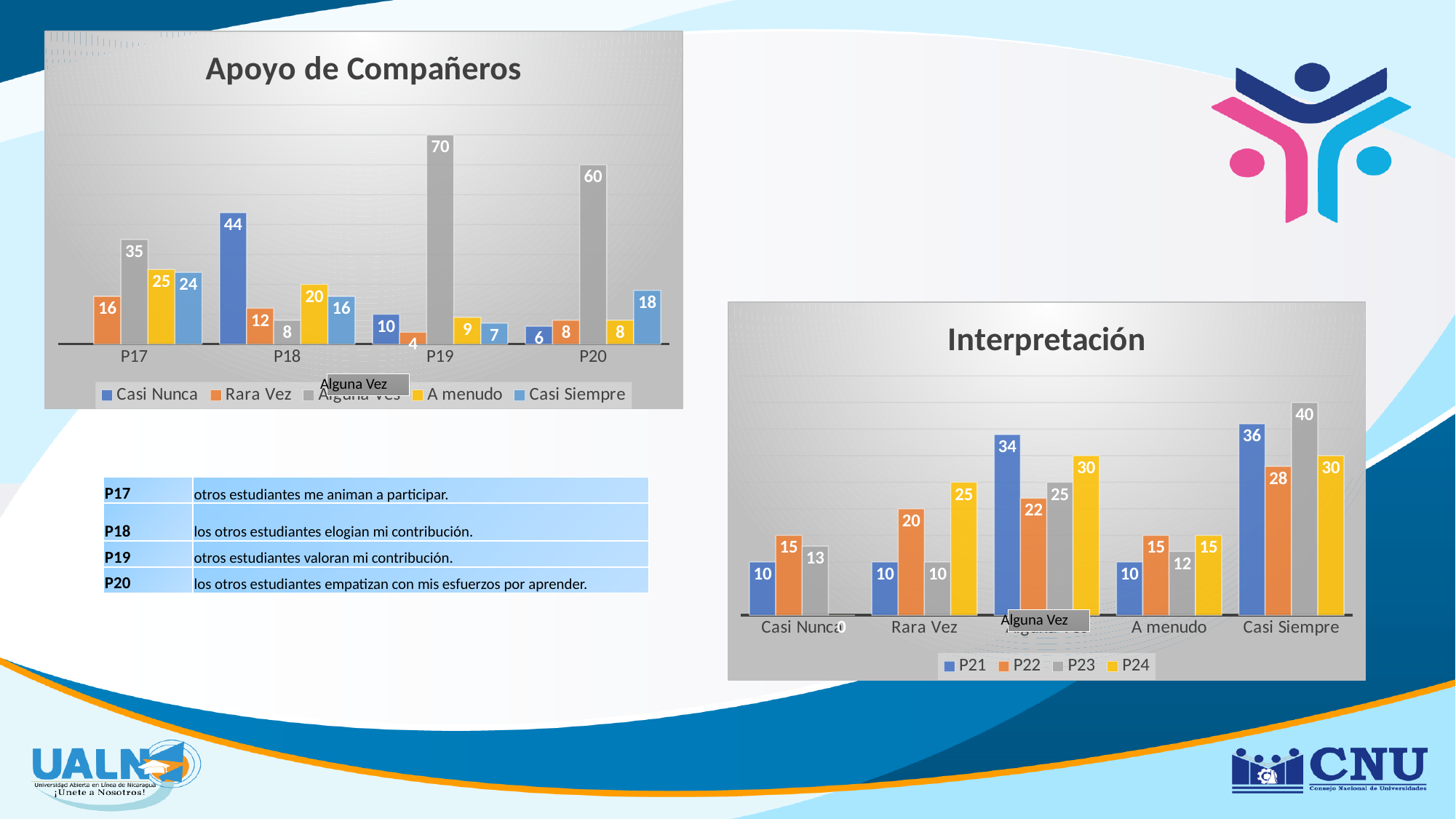
In the 'Interpretación' chart, what is the value of P23 for Casi Siempre? 40 In the 'Interpretación' chart, what is the value of P21 for Alguna Vez? 34 In the 'Interpretación' chart, which series has the highest value for Rara Vez? P24 In the 'Apoyo de Compañeros' chart, which series has the highest value for P20? Alguna Vez What kind of chart is 'Interpretación'? bar chart In the 'Apoyo de Compañeros' chart, which series has the lowest value for P19? Rara Vez In the 'Apoyo de Compañeros' chart, how many series does the legend list? 5 In the 'Apoyo de Compañeros' chart, what is the difference between Alguna Vez for P19 and Alguna Vez for P20? 10 In the 'Interpretación' chart, is P22 for Casi Siempre larger or smaller than P24 for Casi Siempre? smaller In the 'Interpretación' chart, how many categories are shown on the x axis? 5 In the 'Apoyo de Compañeros' chart, what is the value of Casi Nunca for P18? 44 In the 'Apoyo de Compañeros' chart, what is the value of Alguna Vez for P19? 70